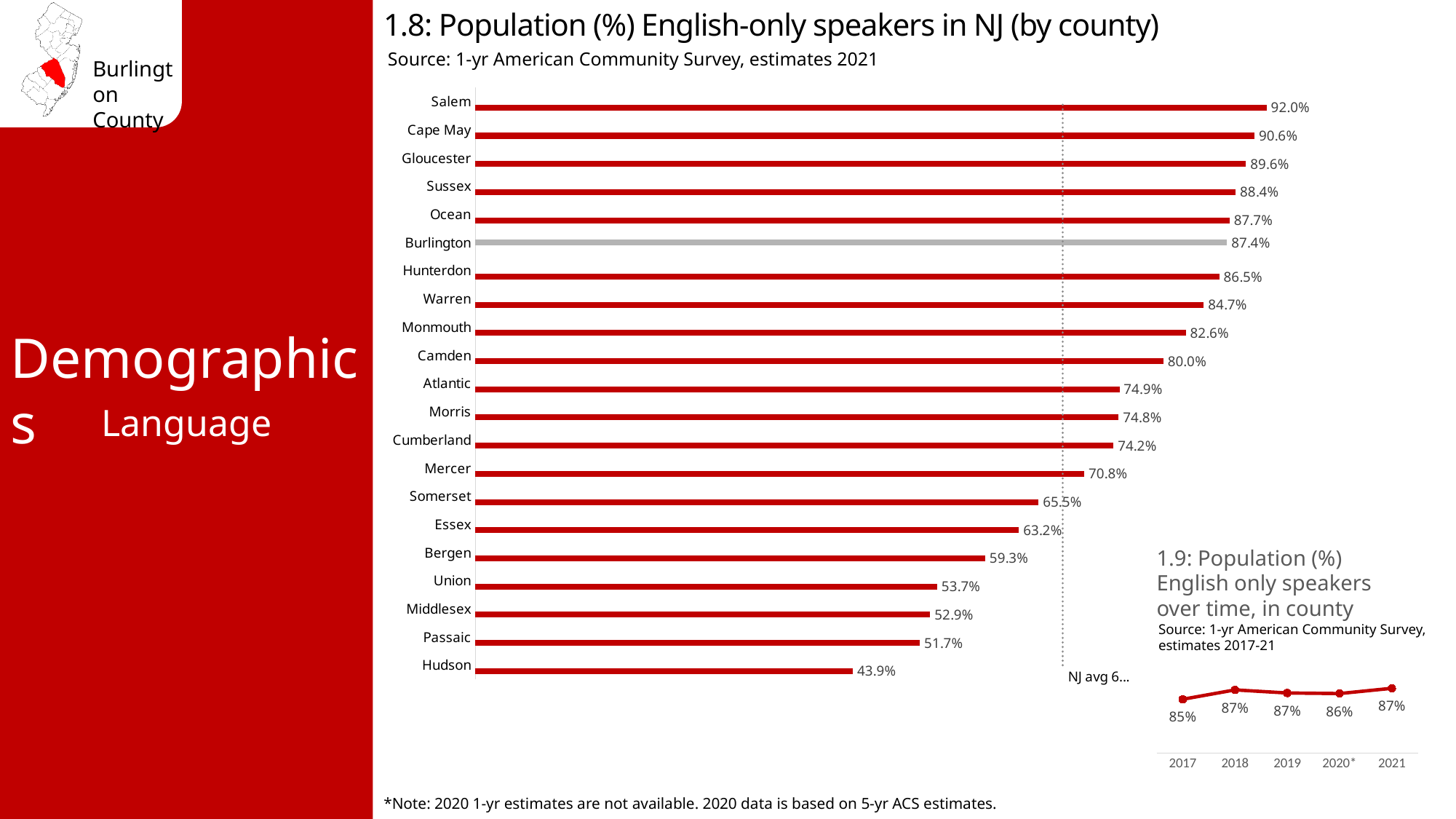
In chart 1.8, which is larger, the value for Camden or the value for Mercer? Camden In chart 1.9, what is the value for 2017? 85% In chart 1.9, what is the value for 2021? 87% In chart 1.8, which county has the highest percentage of English-only speakers? Salem In chart 1.8, which county has the lowest percentage of English-only speakers? Hudson What kind of chart is chart 1.8? Bar chart What kind of chart is chart 1.9? Line chart In chart 1.8, what is the value for Burlington? 87.4% In chart 1.9, how many years are plotted? 5 In chart 1.8, what is the value for Hudson? 43.9% In chart 1.8, what is the difference between the values for Salem and Hudson? 48.1% In chart 1.8, how many counties are shown? 21